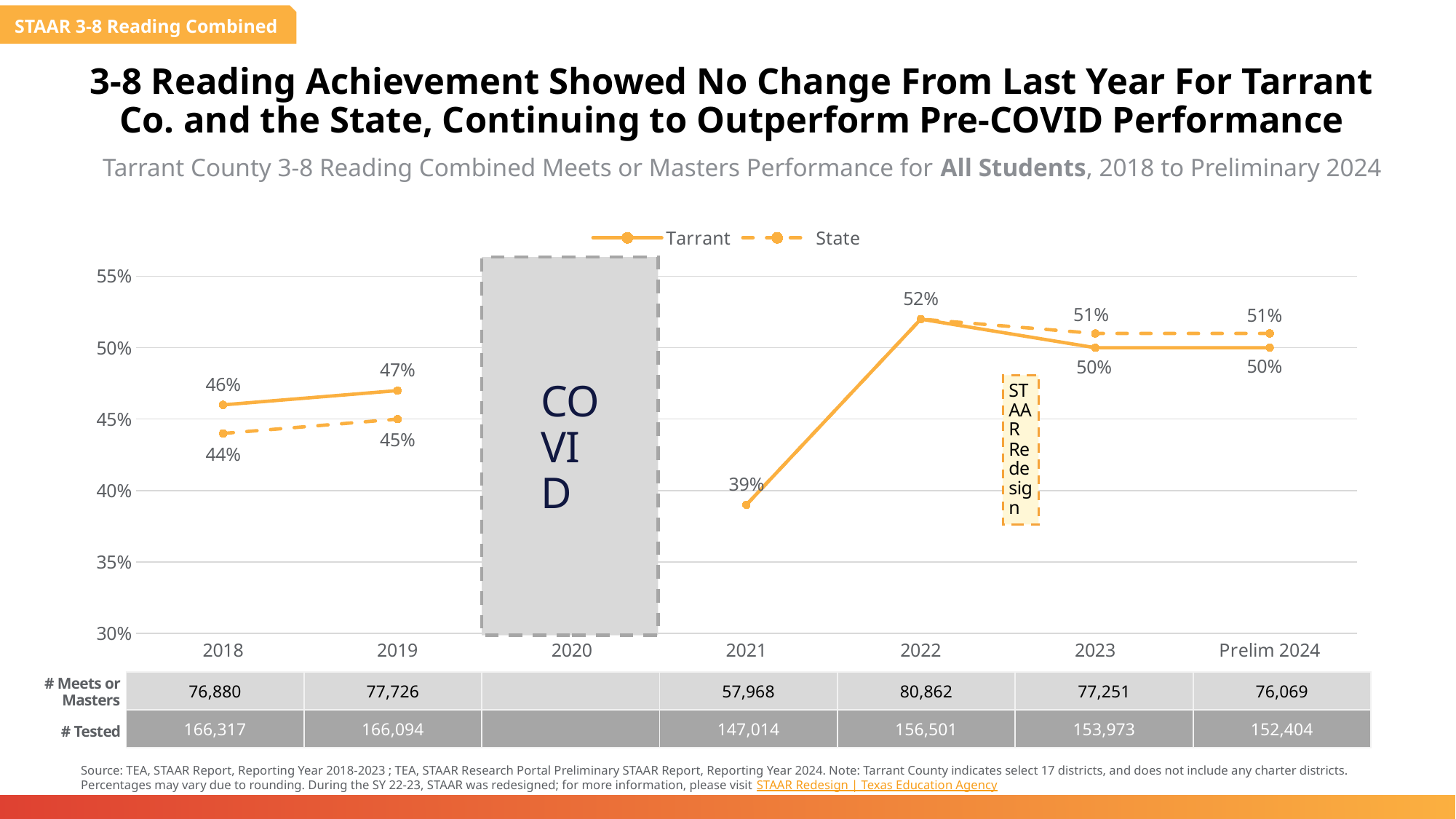
What is the State value for 2019? 45% What is the State value for Prelim 2024? 51% Does the Tarrant value rise or fall from 2018 to 2019? Rise What is the Tarrant value for 2023? 50% What is the difference between the Tarrant and State values in 2018? 2 percentage points What is the Tarrant value for 2021? 39% What is the Tarrant value for 2018? 46% What kind of chart is shown on the slide? Line chart In which year is the Tarrant value lowest? 2021 How many series does the legend list? 2 In which year is the Tarrant value highest? 2022 In 2023, which is larger, the Tarrant value or the State value? State